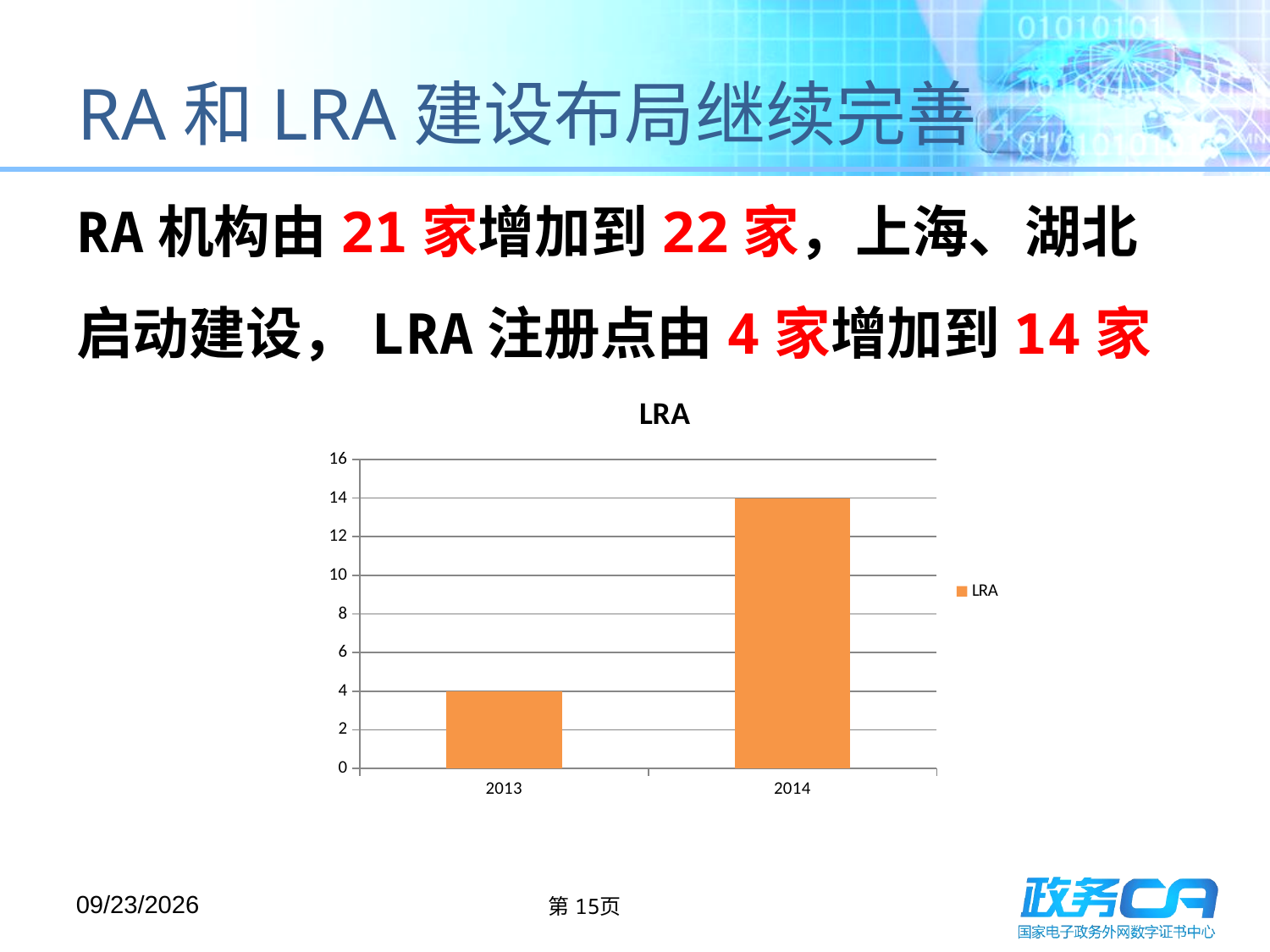
What is the value for 2013 in the LRA chart? 4 Which year has the higher LRA value? 2014 What type of chart is shown on the slide? bar chart What is the value for 2014 in the LRA chart? 14 Is the LRA value for 2013 greater or less than 6? less Which year has the lower LRA value? 2013 Is the LRA value for 2014 greater or less than 10? greater Do the LRA values rise or fall from 2013 to 2014? rise By how much did the LRA value increase from 2013 to 2014? 10 What is the title of the chart? LRA How many categories are shown on the x axis of the chart? 2 How many series does the chart legend list? 1